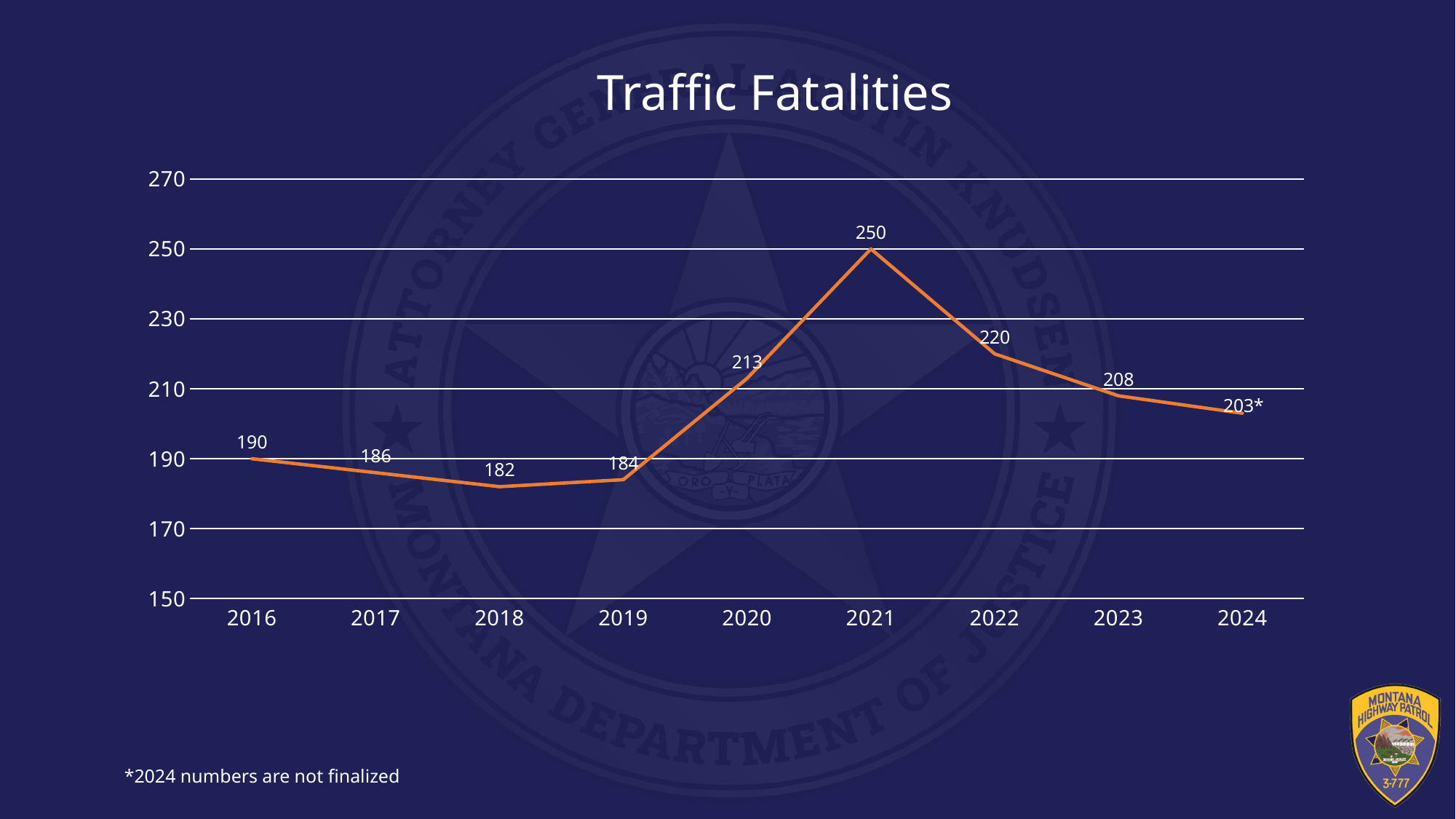
What is the difference between the 2021 and 2022 values? 30 What is the value shown for 2024 in the Traffic Fatalities chart? 203* Which year has a higher value, 2016 or 2023? 2023 What is the difference between the 2020 and 2019 values? 29 What is the value for 2021 in the Traffic Fatalities chart? 250 Do the values rise or fall from 2021 to 2024? fall Which year has the lowest number of traffic fatalities? 2018 Which year has the highest number of traffic fatalities? 2021 What kind of chart is shown on the slide? line chart How many years are plotted on the x axis? 9 Is the value for 2022 greater or less than 210? greater What is the value for 2018 in the Traffic Fatalities chart? 182